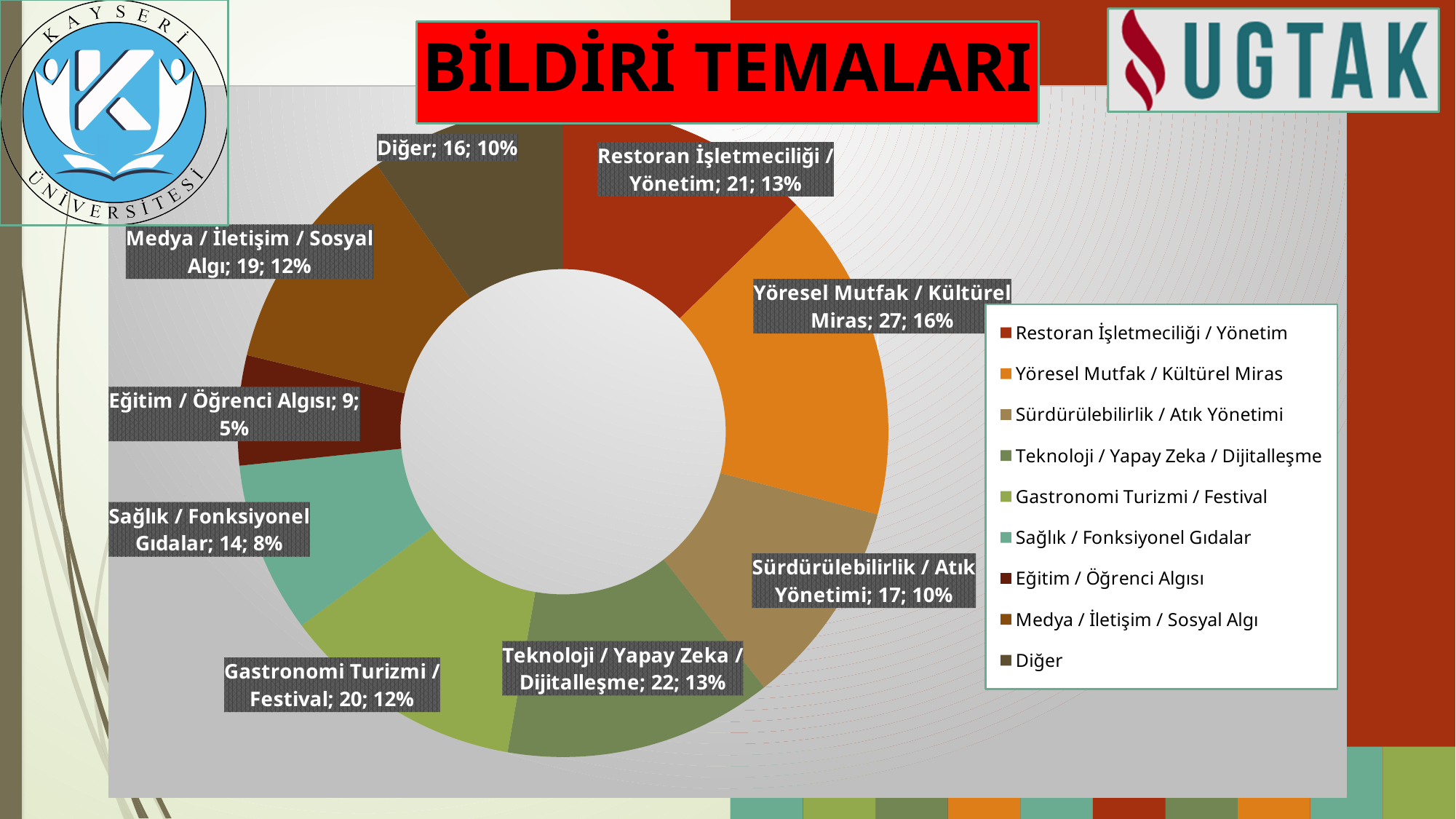
What is the value for Yöresel Mutfak / Kültürel Miras? 27 Which category has the highest value? Yöresel Mutfak / Kültürel Miras What is the title of the chart? BİLDİRİ TEMALARI What percentage share does Teknoloji / Yapay Zeka / Dijitalleşme have? 13% What is the value for Diğer? 16 Which is larger, the value for Gastronomi Turizmi / Festival or the value for Sağlık / Fonksiyonel Gıdalar? Gastronomi Turizmi / Festival What percentage share does Medya / İletişim / Sosyal Algı have? 12% Which category has the lowest value? Eğitim / Öğrenci Algısı What is the value for Sürdürülebilirlik / Atık Yönetimi? 17 How many categories does the chart show? 9 What kind of chart is shown on the slide? Doughnut (pie) chart What is the difference between the values for Yöresel Mutfak / Kültürel Miras and Eğitim / Öğrenci Algısı? 18